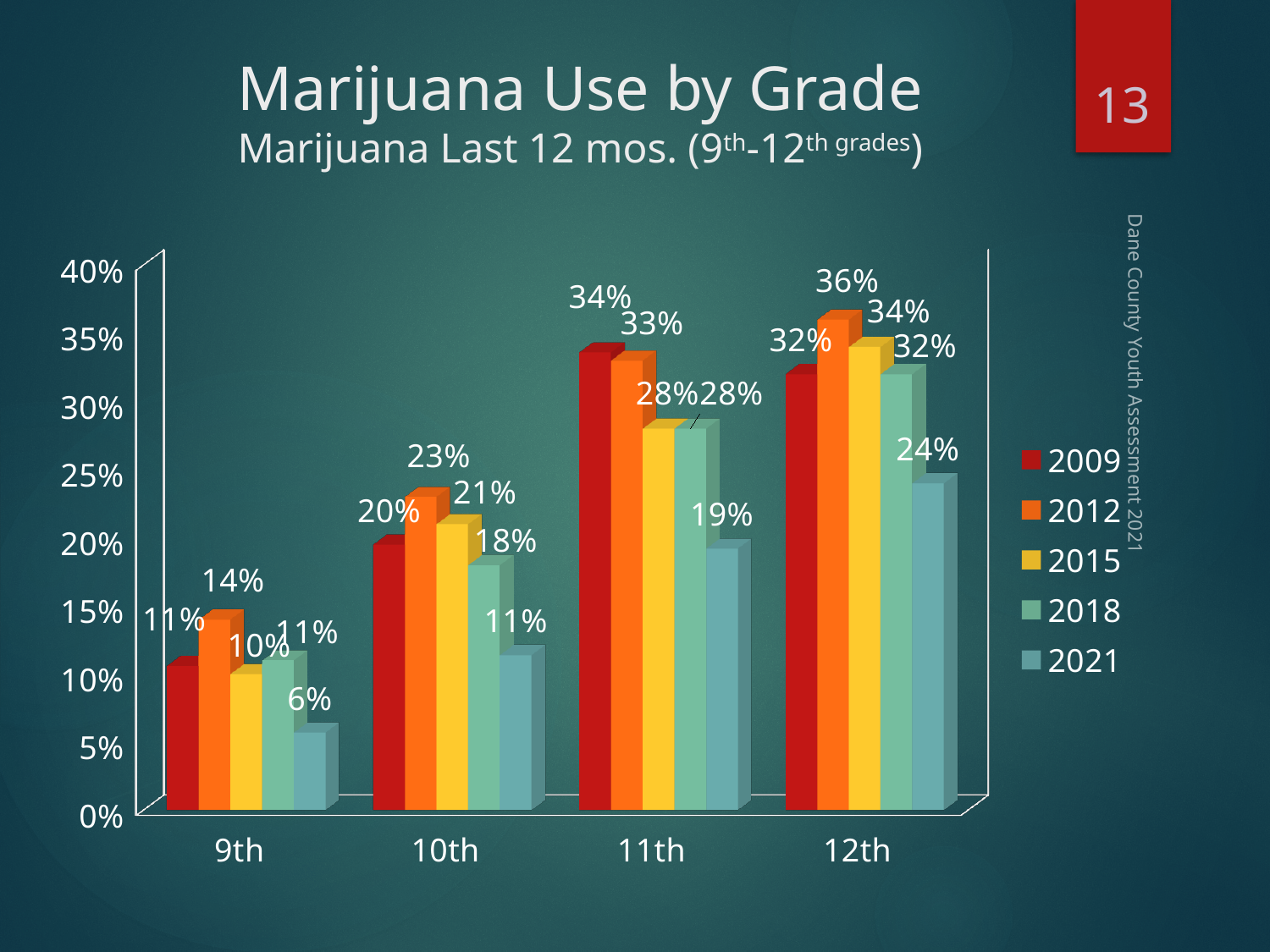
What is the value for 2015 in the 10th grade group? 21% Which grade has the lowest value for 2012? 9th Do the 2021 values rise or fall from 9th grade to 12th grade? Rise Which is larger for 10th grade, the 2009 value or the 2018 value? 2009 What is the value for 2021 in the 9th grade group? 6% What is the value for 2009 in the 11th grade group? 34% Which grade has the highest value for 2021? 12th What is the difference between the 2012 and 2021 values for 12th grade? 12% What is the value for 2012 in the 12th grade group? 36% What kind of chart is shown on the slide? Bar chart How many series does the legend list? 5 How many grade categories are shown on the x axis? 4